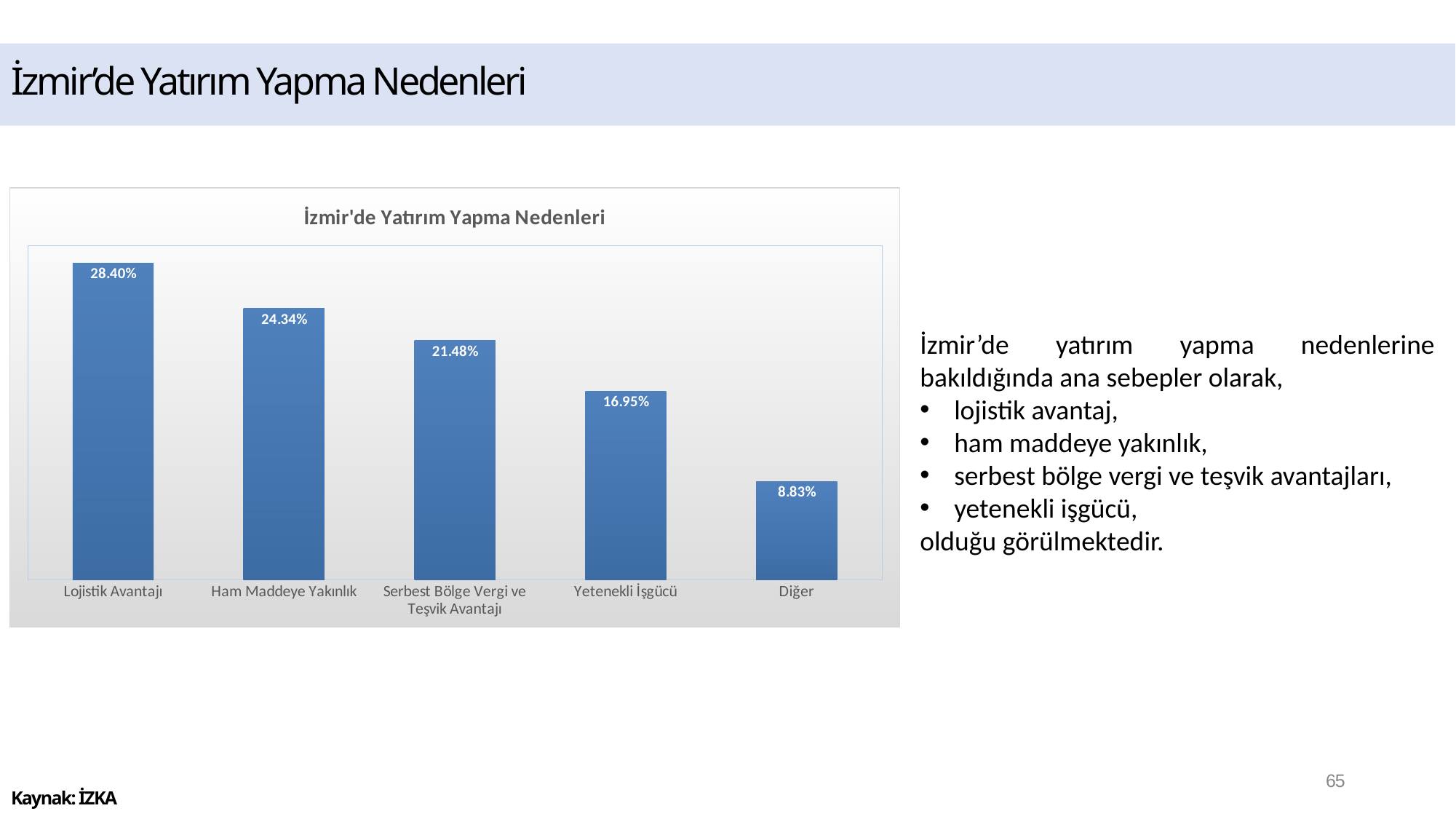
What is the value for Lojistik Avantajı? 28.40% Which is larger, the value for Yetenekli İşgücü or the value for Diğer? Yetenekli İşgücü What is the value for Serbest Bölge Vergi ve Teşvik Avantajı? 21.48% How many categories are shown in the chart? 5 What is the value for Diğer? 8.83% What is the title of the chart? İzmir'de Yatırım Yapma Nedenleri What is the difference between the values for Lojistik Avantajı and Ham Maddeye Yakınlık? 4.06% What is the value for Yetenekli İşgücü? 16.95% Which category has the highest value? Lojistik Avantajı What is the value for Ham Maddeye Yakınlık? 24.34% What kind of chart is shown on the slide? Bar chart Which category has the lowest value? Diğer